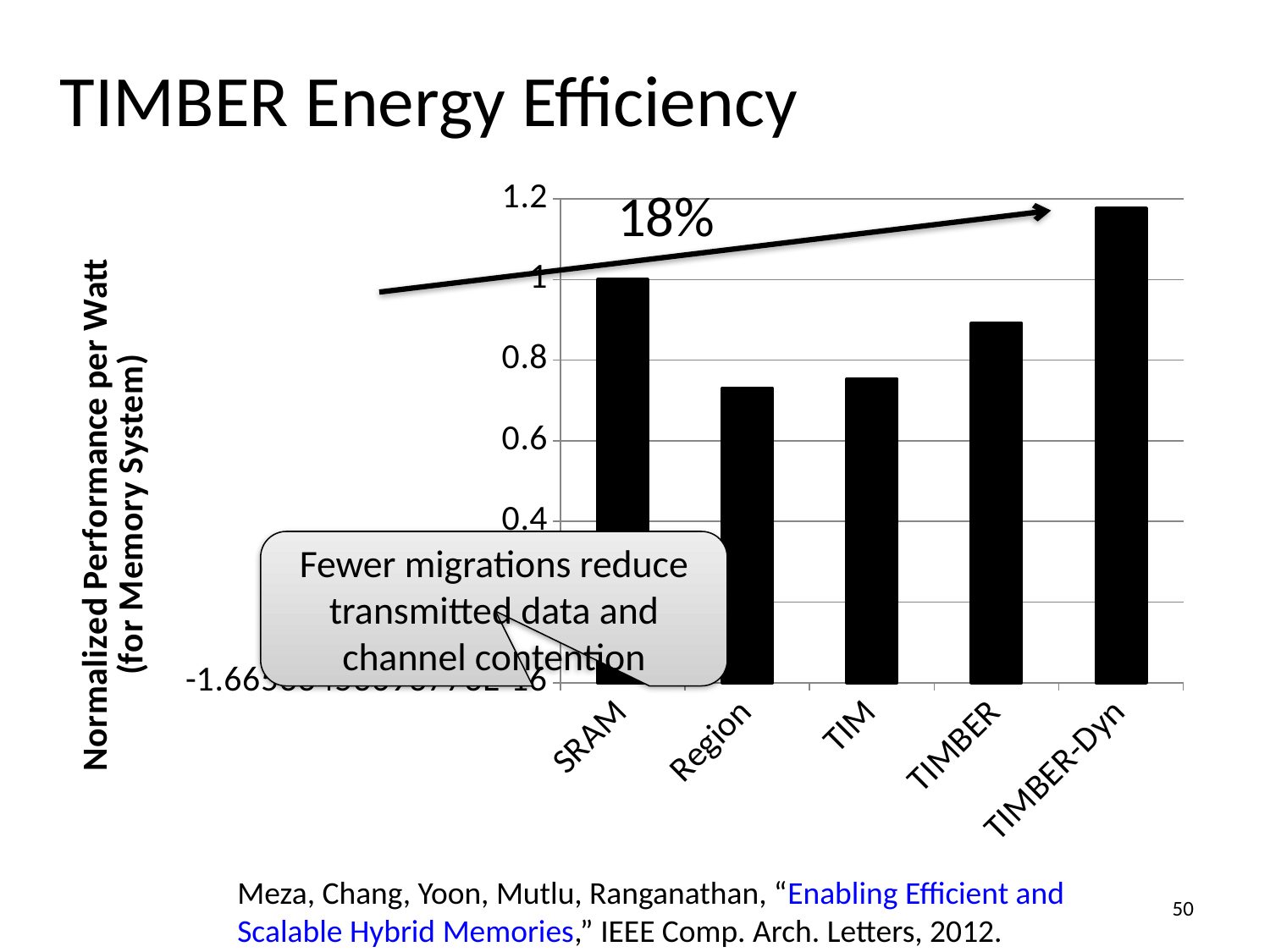
Is the value for TIMBER greater or less than 0.8? greater What is the normalized performance per watt for SRAM? 1 How many categories are shown on the x axis of the chart? 5 Which has a larger value, SRAM or TIMBER? SRAM Is the value for TIMBER-Dyn greater or less than 1? greater What is the title of the y axis of the chart? Normalized Performance per Watt (for Memory System) Is the value for Region greater or less than 0.8? less What percentage is written next to the arrow annotation above the bars? 18% Which category has the highest normalized performance per watt? TIMBER-Dyn What kind of chart is shown on the slide? bar chart Which has a larger value, TIMBER or Region? TIMBER